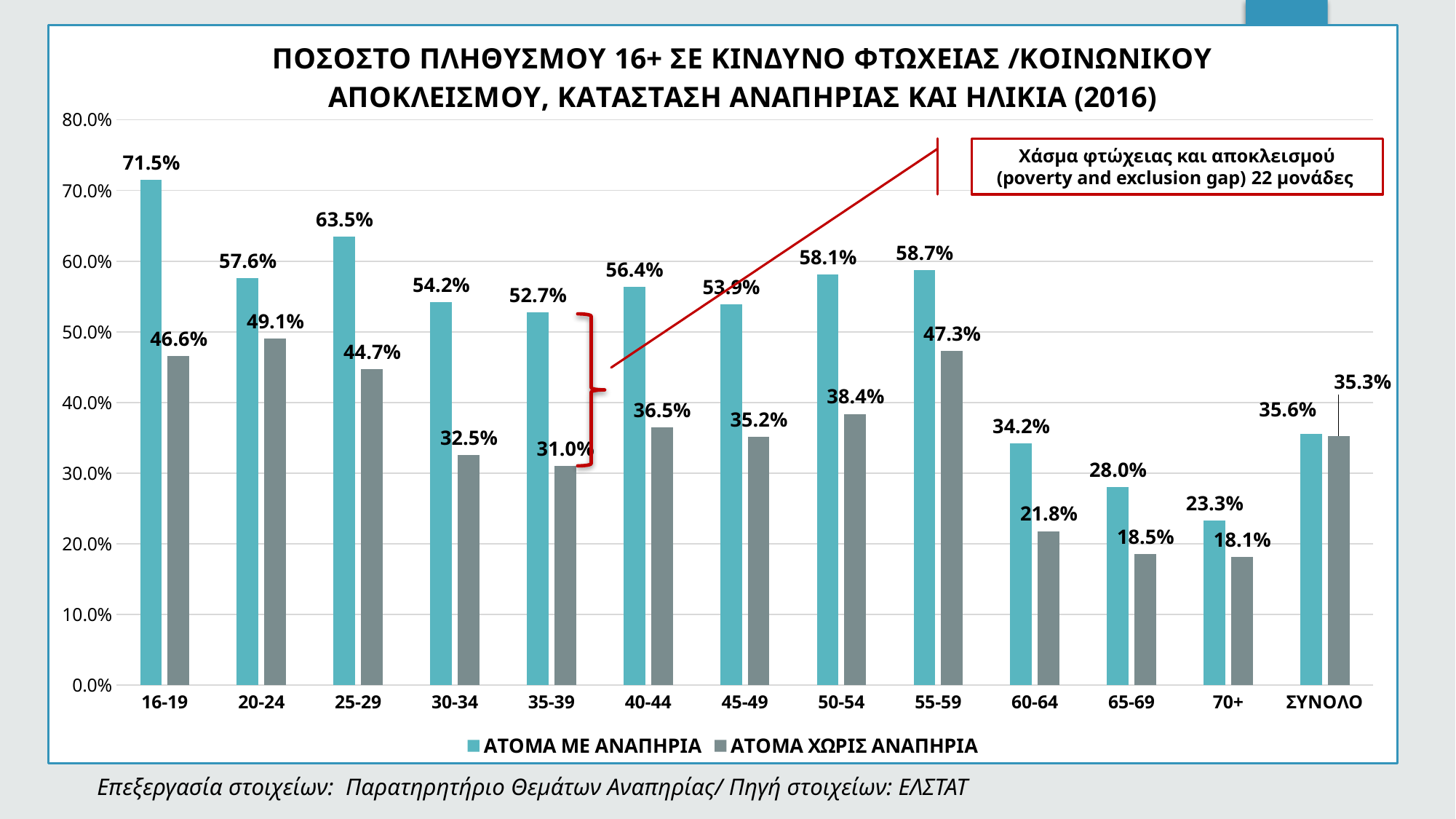
Which colour represents ΑΤΟΜΑ ΧΩΡΙΣ ΑΝΑΠΗΡΙΑ in the legend? Grey How many categories are shown on the x axis? 13 What is the value for ΑΤΟΜΑ ΜΕ ΑΝΑΠΗΡΙΑ in the 16-19 age group? 71.5% What is the value for ΑΤΟΜΑ ΧΩΡΙΣ ΑΝΑΠΗΡΙΑ in the 35-39 age group? 31.0% What kind of chart is shown on the slide? Bar chart How many series does the legend list? 2 Is the value for ΑΤΟΜΑ ΜΕ ΑΝΑΠΗΡΙΑ in the 25-29 age group greater or less than 60.0%? greater Which age group has the highest value for ΑΤΟΜΑ ΜΕ ΑΝΑΠΗΡΙΑ? 16-19 Which age group has the lowest value for ΑΤΟΜΑ ΧΩΡΙΣ ΑΝΑΠΗΡΙΑ? 70+ What is the value for ΑΤΟΜΑ ΜΕ ΑΝΑΠΗΡΙΑ for ΣΥΝΟΛΟ? 35.6% Which is larger in the 55-59 age group: ΑΤΟΜΑ ΜΕ ΑΝΑΠΗΡΙΑ or ΑΤΟΜΑ ΧΩΡΙΣ ΑΝΑΠΗΡΙΑ? ΑΤΟΜΑ ΜΕ ΑΝΑΠΗΡΙΑ What is the difference between ΑΤΟΜΑ ΜΕ ΑΝΑΠΗΡΙΑ and ΑΤΟΜΑ ΧΩΡΙΣ ΑΝΑΠΗΡΙΑ in the 35-39 age group? 21.7%